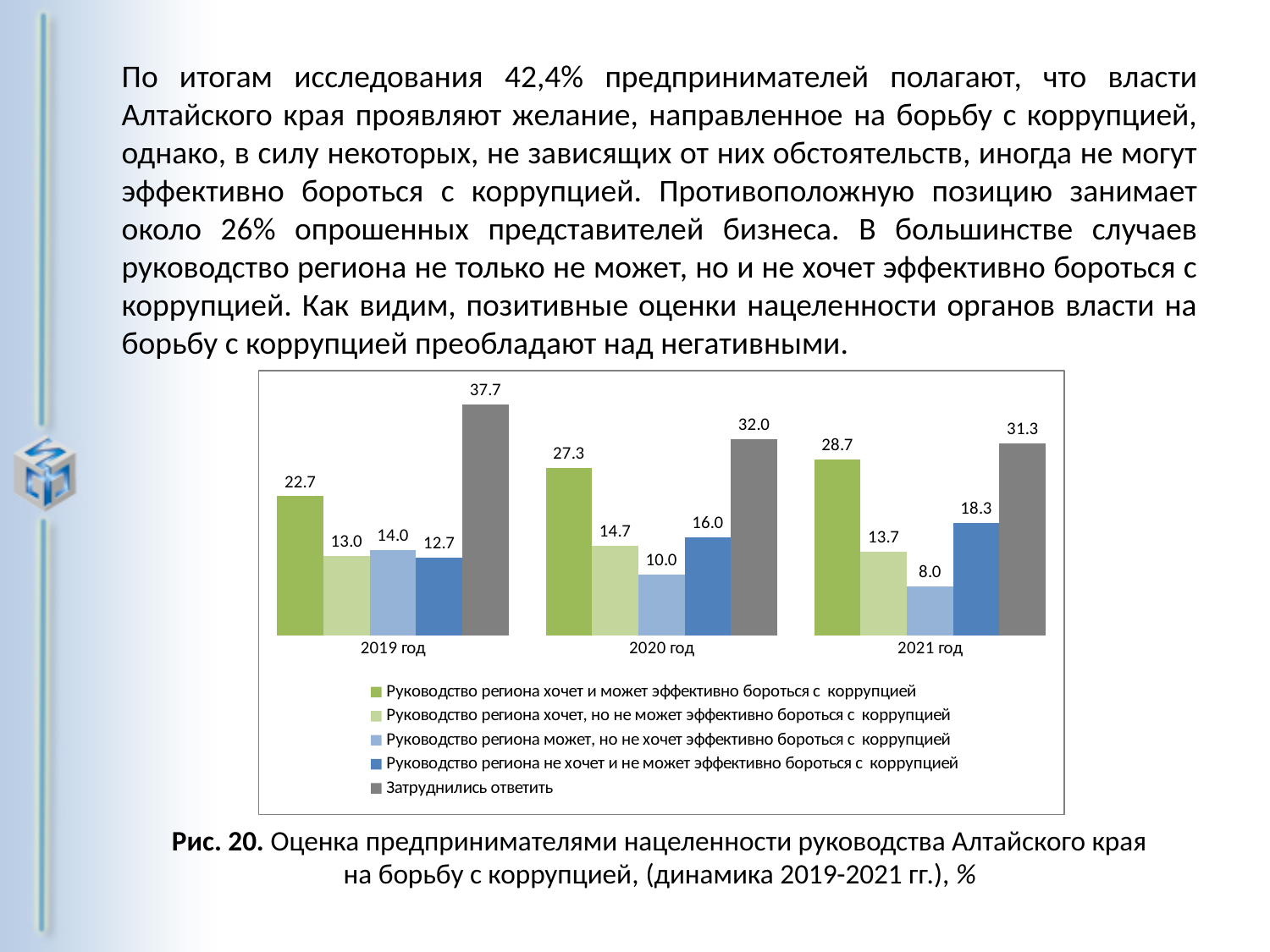
What is the value for 'Руководство региона не хочет и не может эффективно бороться с коррупцией' in 2021 год? 18.3 What kind of chart is shown on the slide? Bar chart What is the value for 'Затруднились ответить' in 2020 год? 32.0 What is the value for 'Руководство региона хочет и может эффективно бороться с коррупцией' in 2019 год? 22.7 How many series does the legend list? 5 Does the value for 'Руководство региона хочет и может эффективно бороться с коррупцией' rise or fall from 2019 год to 2021 год? Rise Which is larger in 2020 год: 'Руководство региона хочет, но не может эффективно бороться с коррупцией' or 'Руководство региона не хочет и не может эффективно бороться с коррупцией'? Руководство региона не хочет и не может эффективно бороться с коррупцией What is the value for 'Руководство региона может, но не хочет эффективно бороться с коррупцией' in 2021 год? 8.0 In which year is the value for 'Затруднились ответить' the highest? 2019 год What is the difference between the 'Руководство региона хочет и может эффективно бороться с коррупцией' values for 2021 год and 2019 год? 6.0 How many year categories are shown on the x axis? 3 In which year is the value for 'Руководство региона может, но не хочет эффективно бороться с коррупцией' the lowest? 2021 год